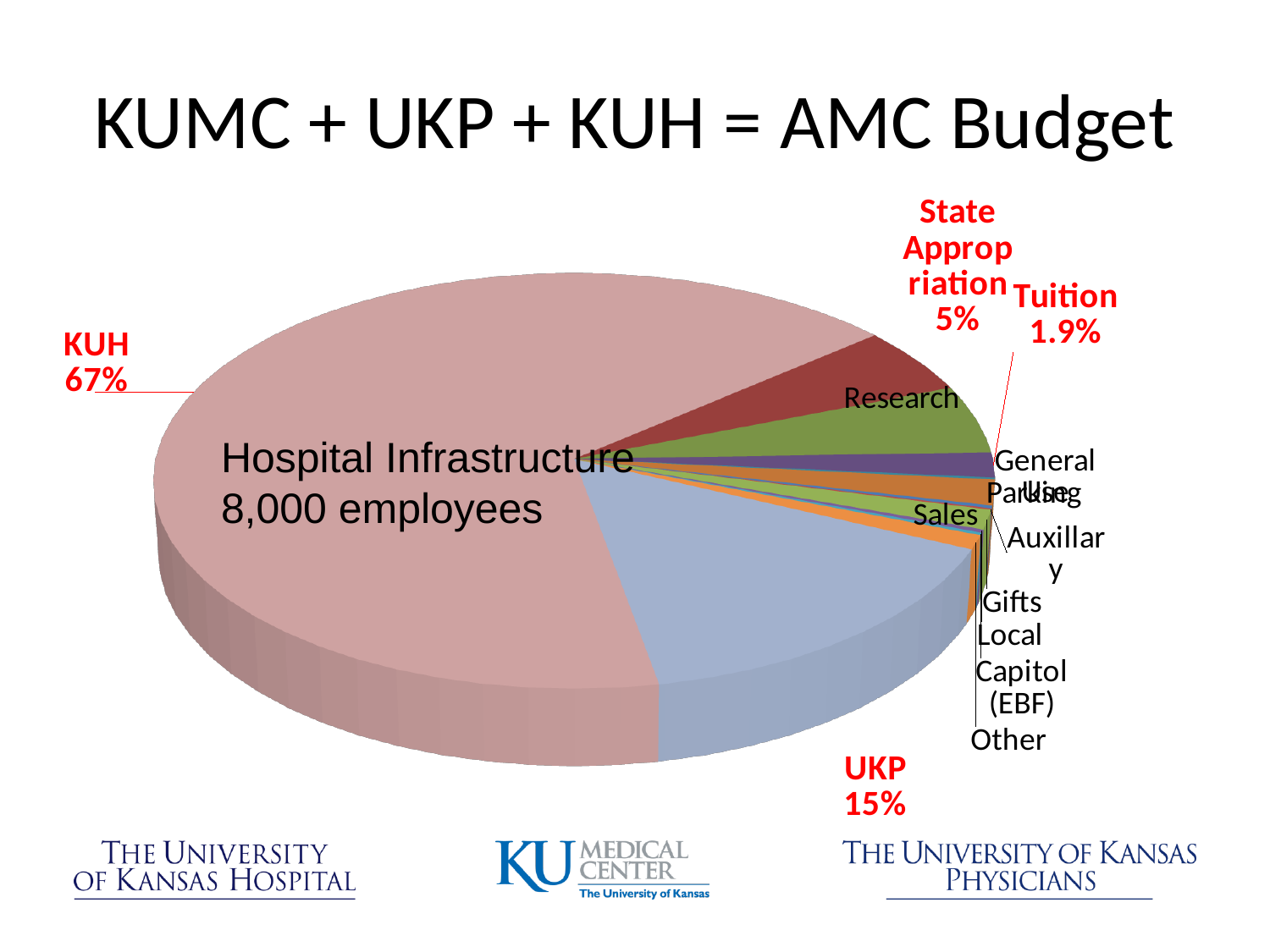
By how many percentage points does State Appropriation exceed Tuition? 3.1 percentage points What percentage of the AMC budget does KUH account for? 67% Which is larger, State Appropriation or Tuition? State Appropriation What is the title of the slide containing the pie chart? KUMC + UKP + KUH = AMC Budget What percentage of the AMC budget does UKP account for? 15% By how many percentage points does KUH exceed UKP? 52 percentage points What text is written inside the largest slice of the pie? Hospital Infrastructure 8,000 employees What percentage is shown for Tuition? 1.9% What percentage is shown for State Appropriation? 5% Which is larger, the KUH slice or the UKP slice? KUH Which slice of the pie is the largest? KUH What type of chart is shown on the slide? Pie chart